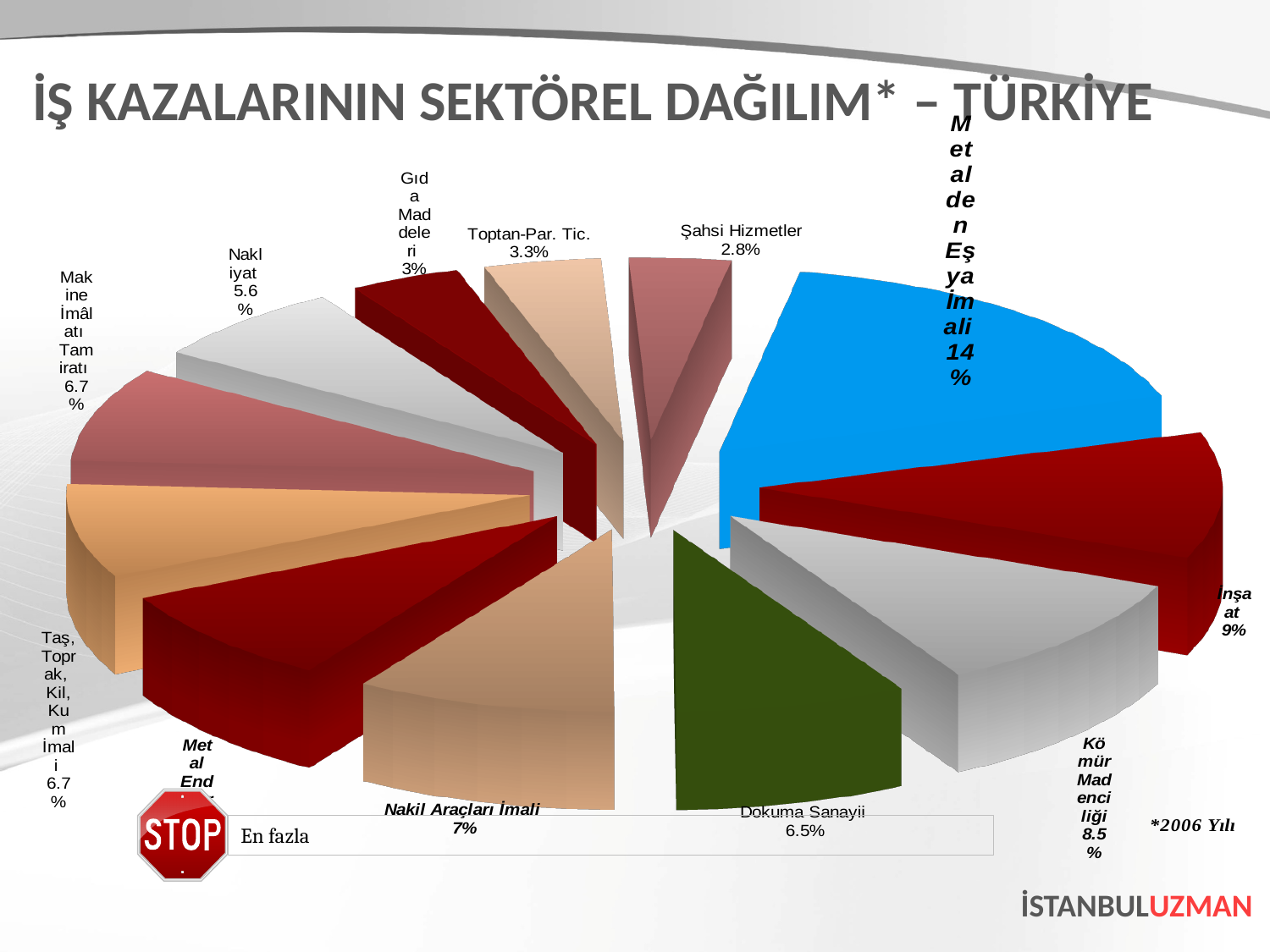
Which has a larger share, İnşaat or Kömür Madenciliği? İnşaat Which labelled sector has the smallest share in the pie chart? Şahsi Hizmetler What share of work accidents is attributed to Metalden Eşya İmali? 14% What percentage is shown for Nakliyat? 5.6% What type of chart is shown on the slide? Pie chart What is the value for Şahsi Hizmetler? 2.8% What is the difference in percentage points between Metalden Eşya İmali and İnşaat? 5 What is the value for Dokuma Sanayii? 6.5% What is the value shown for İnşaat? 9% What percentage is shown for Kömür Madenciliği? 8.5% Which sector has the largest share in the pie chart? Metalden Eşya İmali Which year does the footnote say the data refers to? 2006